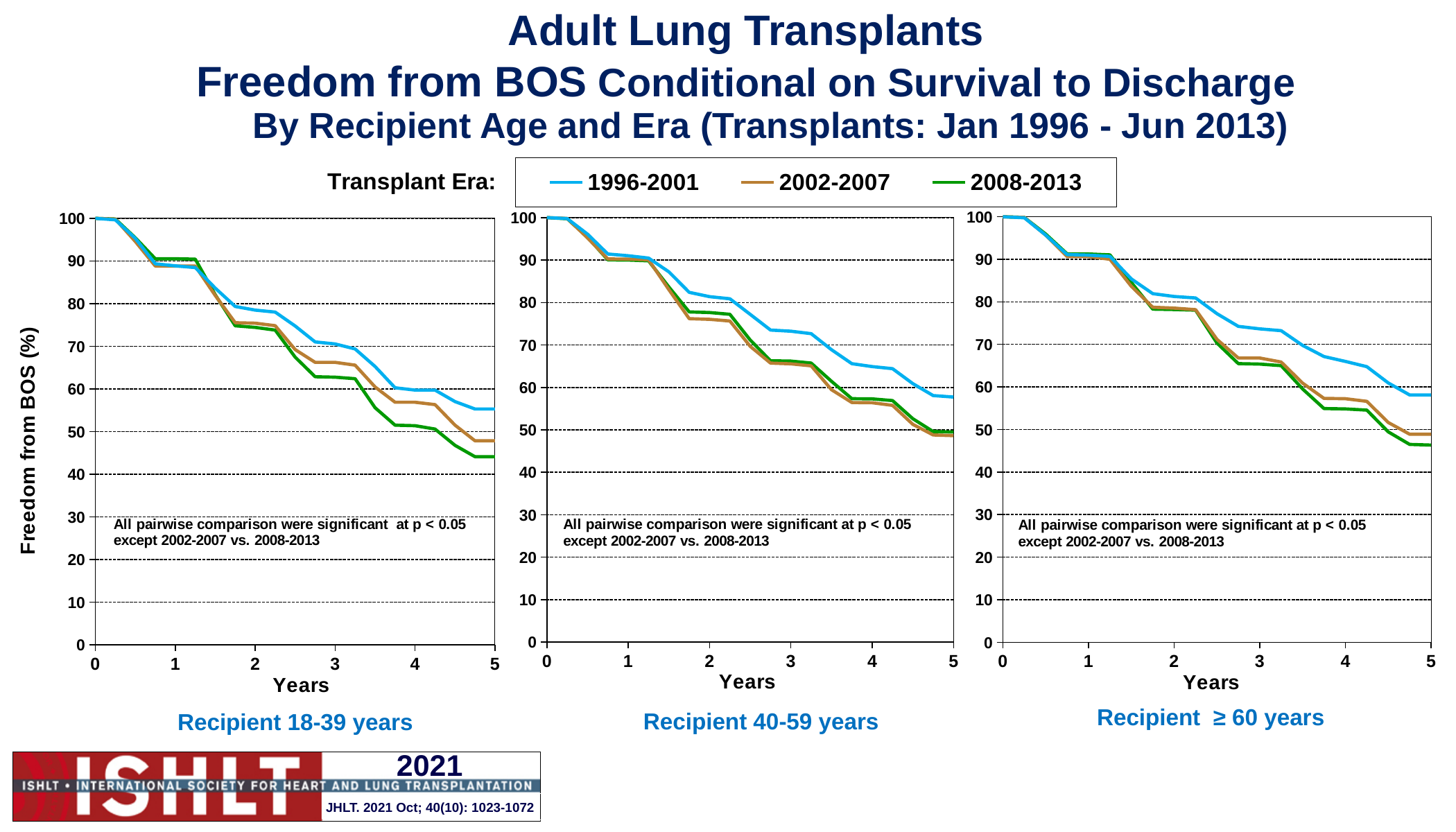
In the Recipient 18-39 years chart, is the value for the 2008-2013 era at year 5 greater or less than 50? less In the Recipient ≥ 60 years chart, is the value for the 2008-2013 era at year 5 greater or less than 50? less What kind of chart is used for the Recipient 18-39 years panel? line chart In the Recipient 18-39 years chart, which era has the lowest freedom from BOS at year 5? 2008-2013 In the Recipient 18-39 years chart, which era has the highest freedom from BOS at year 5? 1996-2001 In the Recipient 18-39 years chart, does freedom from BOS rise or fall as years increase? fall How many transplant eras does the legend list? 3 In the Recipient 40-59 years chart, is the value for the 1996-2001 era at year 5 greater or less than 50? greater Which transplant era is shown in green in the legend? 2008-2013 How many charts are shown on the slide? 3 In the Recipient 18-39 years chart, what is the freedom from BOS value for the 1996-2001 era at year 0? 100